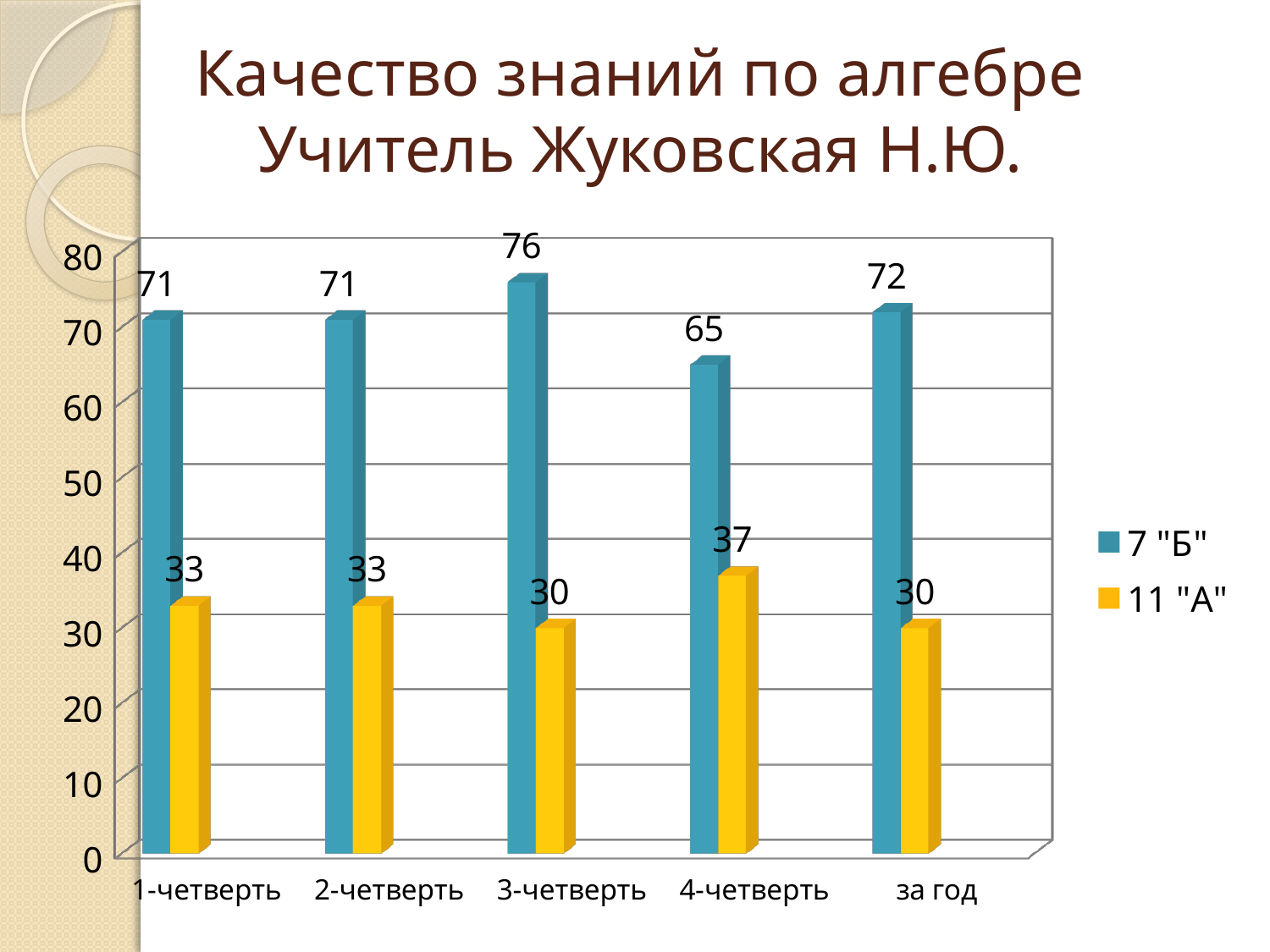
Which colour represents the 11 "А" series? yellow How many categories are shown on the x axis? 5 How many series does the legend list? 2 What is the value for 7 "Б" in 3-четверть? 76 In which category is the value for 11 "А" highest? 4-четверть What is the difference between the 7 "Б" and 11 "А" values in 1-четверть? 38 In which category is the value for 7 "Б" lowest? 4-четверть In which category is the value for 7 "Б" highest? 3-четверть Which is larger in 4-четверть: the value for 7 "Б" or for 11 "А"? 7 "Б" What is the value for 11 "А" in 4-четверть? 37 What is the value for 7 "Б" за год? 72 What kind of chart is shown on the slide? bar chart